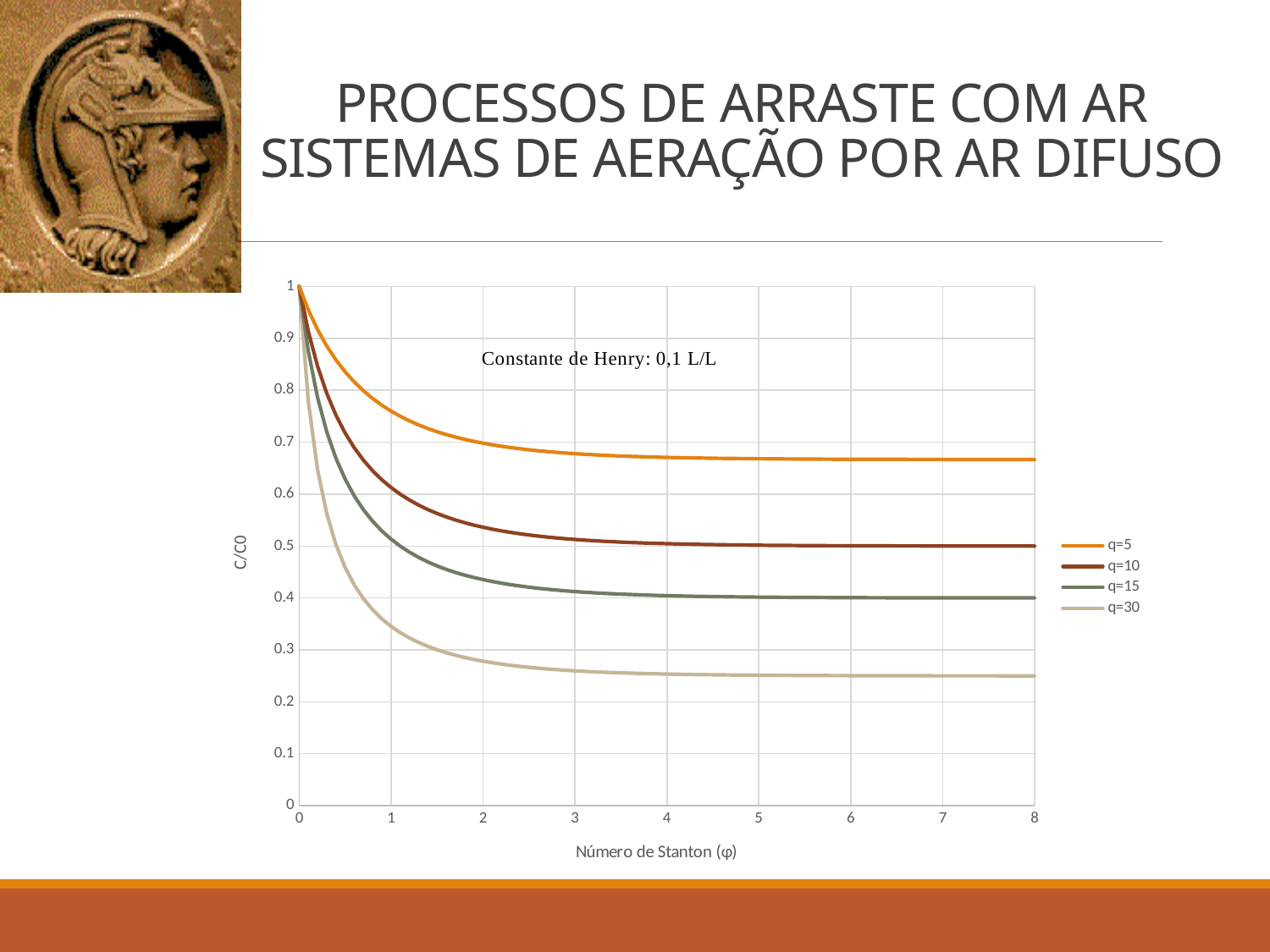
Is the C/C0 value for q=30 at Número de Stanton 8 greater or less than 0.3? less Is the C/C0 value for q=5 at Número de Stanton 8 greater or less than 0.6? greater How many series does the legend list? 4 At Número de Stanton 4, which series has the larger C/C0 value, q=5 or q=30? q=5 Is the C/C0 value for q=10 at Número de Stanton 2 greater or less than 0.6? less Which series has the lowest C/C0 value at Número de Stanton 6? q=30 Do the C/C0 values rise or fall as the Número de Stanton increases? fall What is the C/C0 value of all series at Número de Stanton 0? 1 What kind of chart is shown on the slide? line chart What is the title of the x axis? Número de Stanton (φ) What are the series names listed in the legend? q=5, q=10, q=15, q=30 Which series has the highest C/C0 value at Número de Stanton 6? q=5